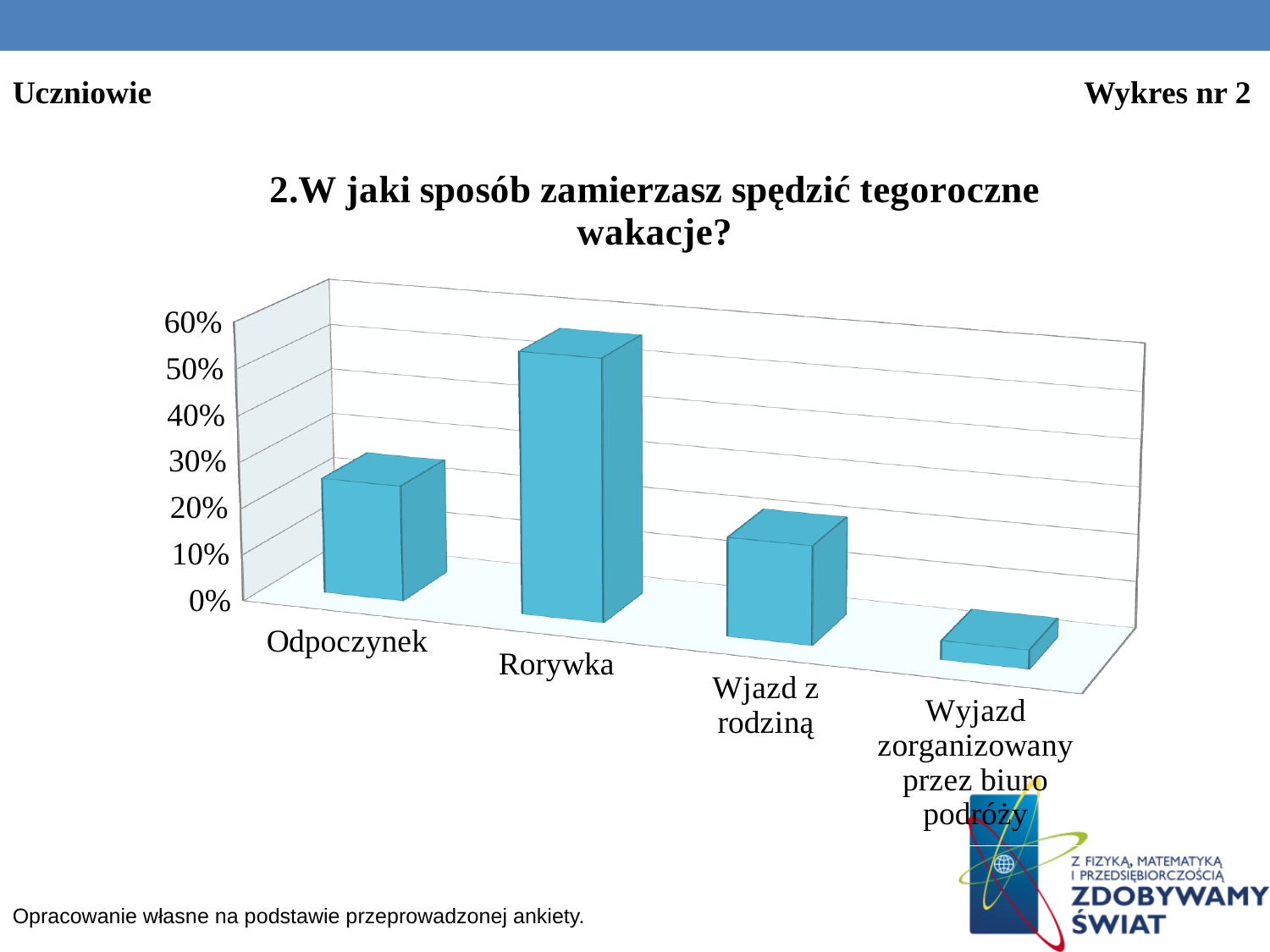
Which is larger, the value for Odpoczynek or the value for Wjazd z rodziną? Odpoczynek How many categories are shown on the chart? 4 Which category has the lowest value? Wyjazd zorganizowany przez biuro podróży Which is larger, the value for Rorywka or the value for Odpoczynek? Rorywka What is the title of the chart? 2.W jaki sposób zamierzasz spędzić tegoroczne wakacje? Is the value for Odpoczynek greater or less than 40%? less Is the value for Wyjazd zorganizowany przez biuro podróży greater or less than 10%? less What kind of chart is shown on the slide? bar chart Is the value for Rorywka greater or less than 40%? greater What is the highest value shown on the vertical axis? 60% Which category has the highest value? Rorywka